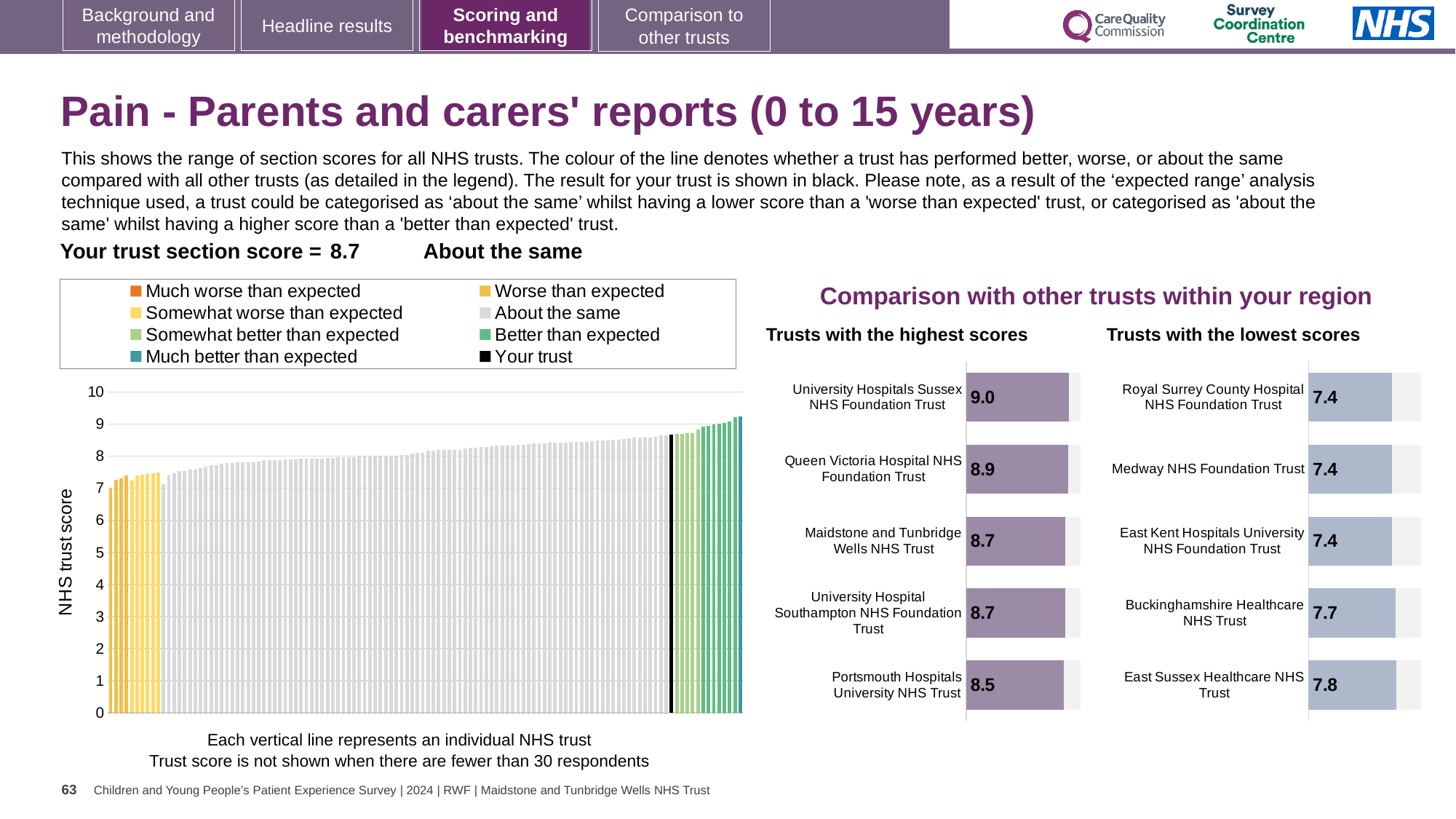
How many entries does the legend of the main chart on the left list? 8 In the main chart on the left, do the trust scores rise or fall from left to right along the x axis? rise In the main chart on the left, is the value of the black 'Your trust' bar greater or less than 8? greater In the 'Trusts with the highest scores' chart, which trust has the highest score? University Hospitals Sussex NHS Foundation Trust In the 'Trusts with the highest scores' chart, what is the difference between the scores of University Hospitals Sussex NHS Foundation Trust and Portsmouth Hospitals University NHS Trust? 0.5 In the main chart on the left showing the range of section scores, what is the section score for your trust (the black bar)? 8.7 In the 'Trusts with the lowest scores' chart, what is the difference between the scores of East Sussex Healthcare NHS Trust and Medway NHS Foundation Trust? 0.4 In the 'Trusts with the highest scores' chart, what is the score for University Hospitals Sussex NHS Foundation Trust? 9.0 In the 'Trusts with the lowest scores' chart, which trust has the highest score shown? East Sussex Healthcare NHS Trust In the 'Trusts with the lowest scores' chart, what is the score for Buckinghamshire Healthcare NHS Trust? 7.7 How many trusts are listed in the 'Trusts with the lowest scores' chart? 5 In the 'Trusts with the highest scores' chart, which has the larger score: Queen Victoria Hospital NHS Foundation Trust or Portsmouth Hospitals University NHS Trust? Queen Victoria Hospital NHS Foundation Trust